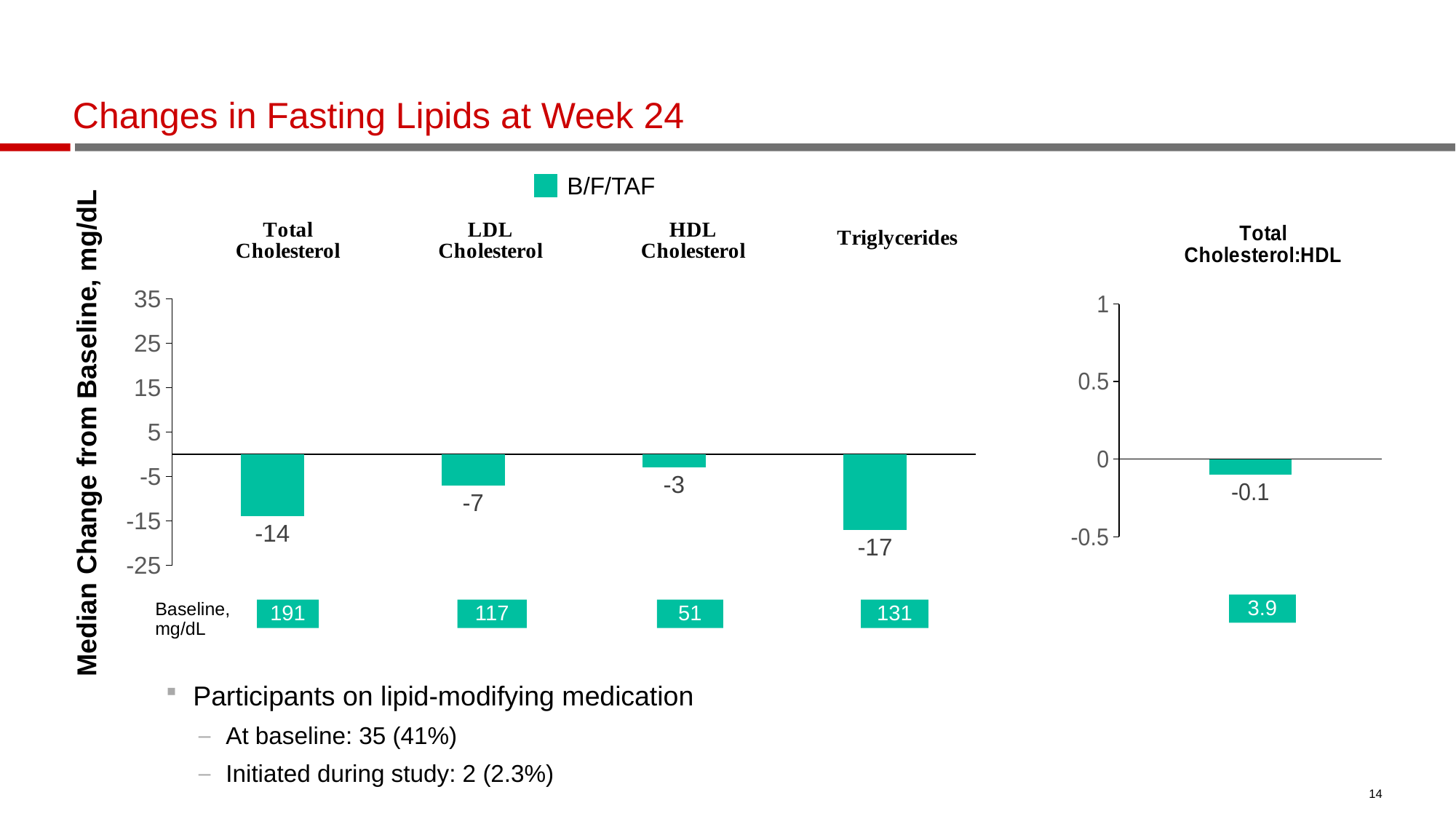
What kind of chart is the left chart? Bar chart In the left chart, what is the difference between the median change for Triglycerides and for Total Cholesterol? 3 In the left chart, which category has the smallest change from baseline? HDL Cholesterol How many categories are plotted in the left chart? 4 In the left chart, which category has the largest decrease from baseline? Triglycerides In the left chart, which has a larger decrease from baseline, LDL Cholesterol or HDL Cholesterol? LDL Cholesterol In the right chart, what is the median change from baseline for Total Cholesterol:HDL? -0.1 In the left chart, what is the median change from baseline for Total Cholesterol? -14 How many series does the legend list? 1 In the left chart, what is the median change from baseline for Triglycerides? -17 What is the baseline value shown for HDL Cholesterol in the left chart? 51 In the left chart, what is the median change from baseline for LDL Cholesterol? -7